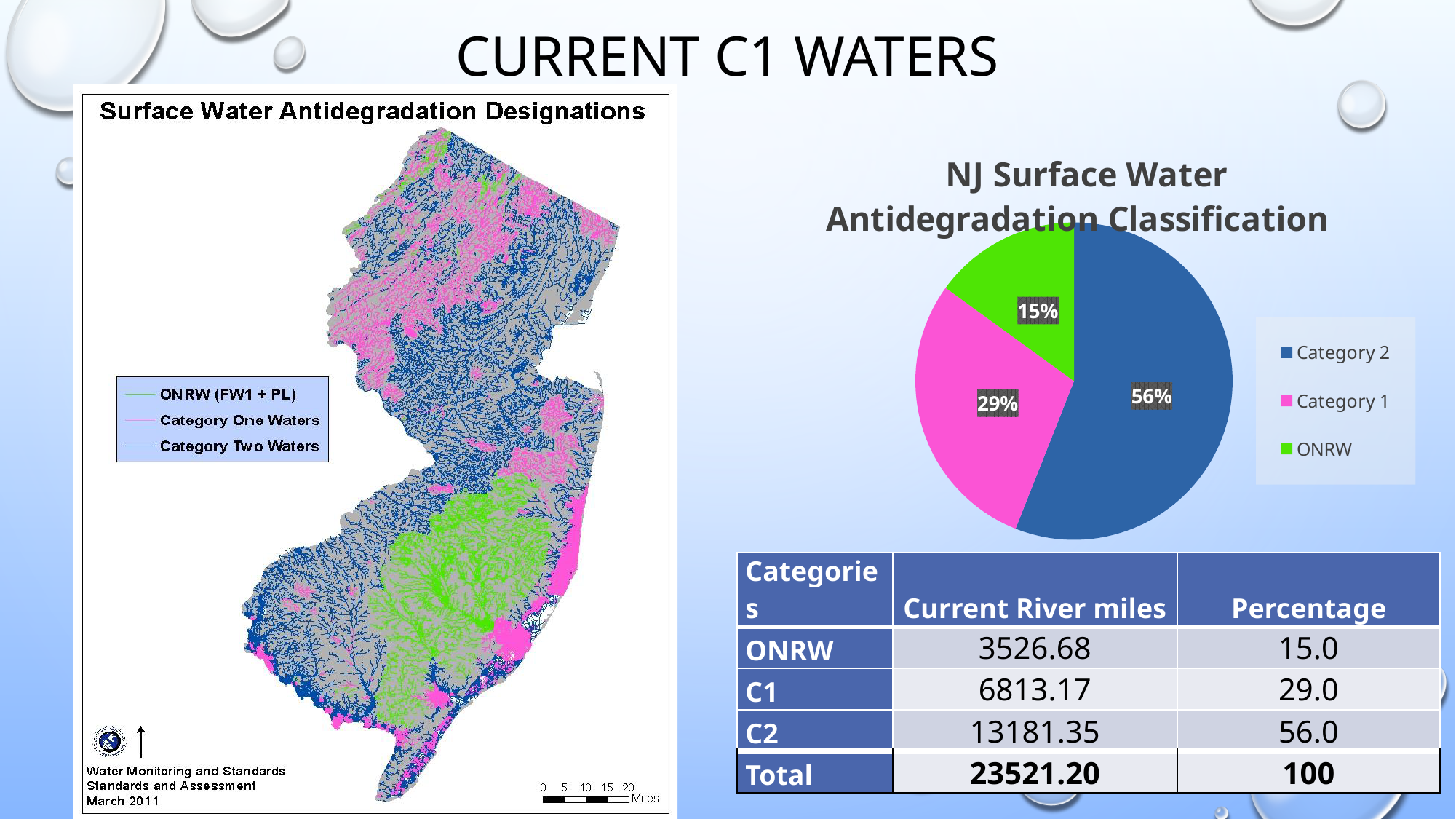
How many slices does the pie chart have? 3 Which category has the smallest slice in the pie chart? ONRW Which category has the largest slice in the pie chart? Category 2 What percentage of the pie chart does Category 2 represent? 56% What type of chart is the NJ Surface Water Antidegradation Classification chart? pie chart What percentage of the pie chart does Category 1 represent? 29% What percentage of the pie chart does ONRW represent? 15% What is the difference in percentage points between Category 2 and Category 1 in the pie chart? 27 What colour is the ONRW slice in the pie chart? green What is the title of the pie chart? NJ Surface Water Antidegradation Classification How many entries does the legend of the pie chart list? 3 Which slice is larger in the pie chart, Category 1 or ONRW? Category 1